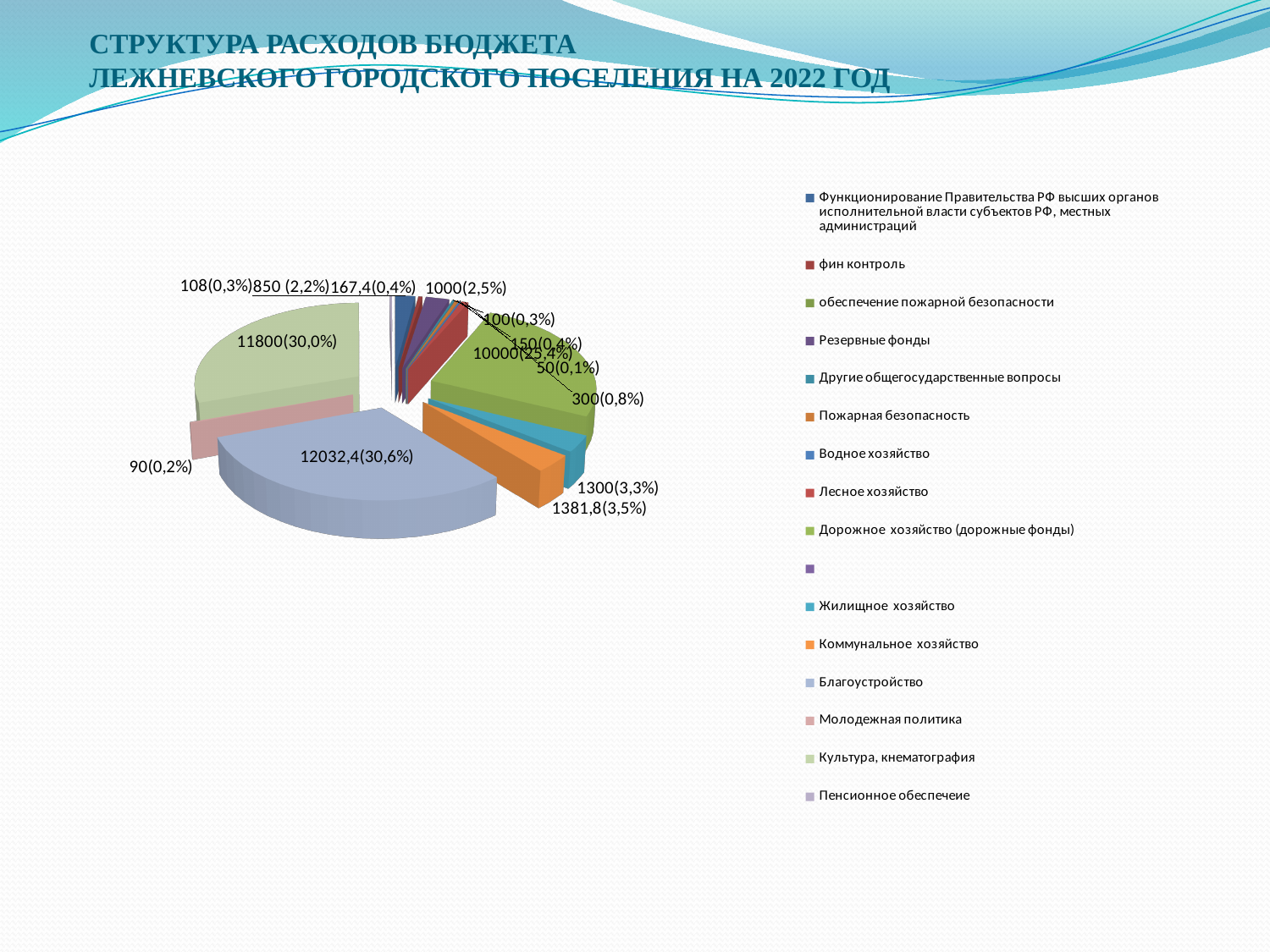
What is the title of the slide's chart? СТРУКТУРА РАСХОДОВ БЮДЖЕТА ЛЕЖНЕВСКОГО ГОРОДСКОГО ПОСЕЛЕНИЯ НА 2022 ГОД How many slices of the pie have data labels? 14 What is the value and share shown for the smallest slice of the pie? 50(0,1%) What is the difference between the slice labelled 12032,4 and the slice labelled 11800? 232,4 What share of the pie does the slice labelled 10000 represent? 25,4% What share of the pie does the slice labelled 11800 represent? 30,0% What is the difference between the slice labelled 1381,8 and the slice labelled 1300? 81,8 What kind of chart is shown on the slide? pie chart Which is larger, the slice labelled 12032,4 or the slice labelled 11800? 12032,4 What share of the pie does the slice labelled 1000 represent? 2,5% What is the value and share shown for the largest slice of the pie? 12032,4(30,6%)